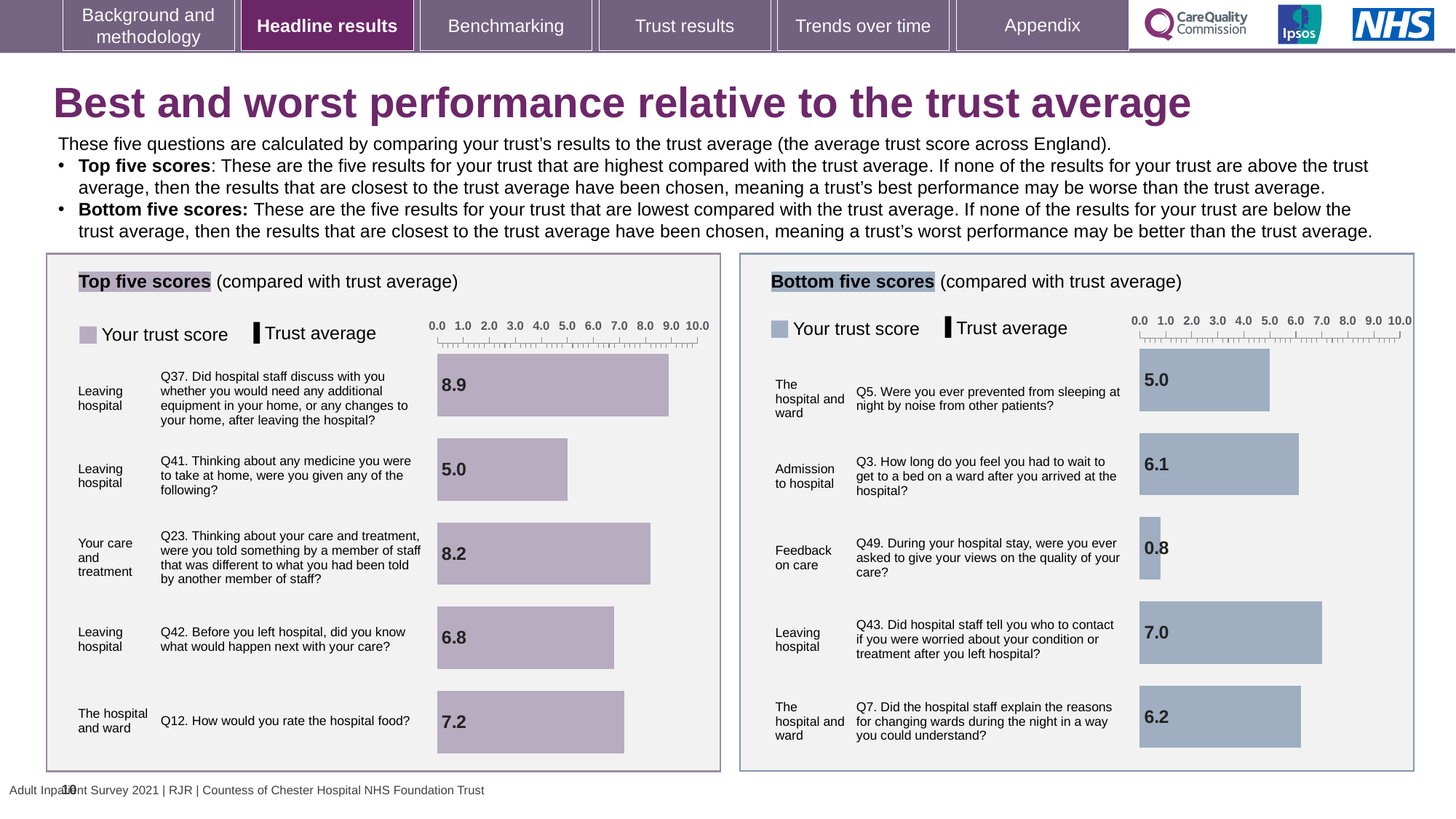
What type of chart is used in the Top five scores panel? Bar chart In the Bottom five scores chart, what is the trust score for Q49 about being asked to give your views on the quality of your care? 0.8 In the Top five scores chart, what is the difference between the trust scores for Q37 and Q41? 3.9 How many series does the legend of the Bottom five scores chart list? 2 In the Top five scores chart, which question has the highest trust score? Q37 In the Bottom five scores chart, what is the difference between the trust scores for Q43 and Q5? 2.0 In the Top five scores chart, what is the trust score for Q12, how would you rate the hospital food? 7.2 In the Top five scores chart, what is the trust score for Q37 about discussing additional equipment or changes to your home after leaving hospital? 8.9 In the Bottom five scores chart, which question has the lowest trust score? Q49 How many questions are shown in the Top five scores chart? 5 In the Bottom five scores chart, what is the trust score for Q43 about being told who to contact if worried after leaving hospital? 7.0